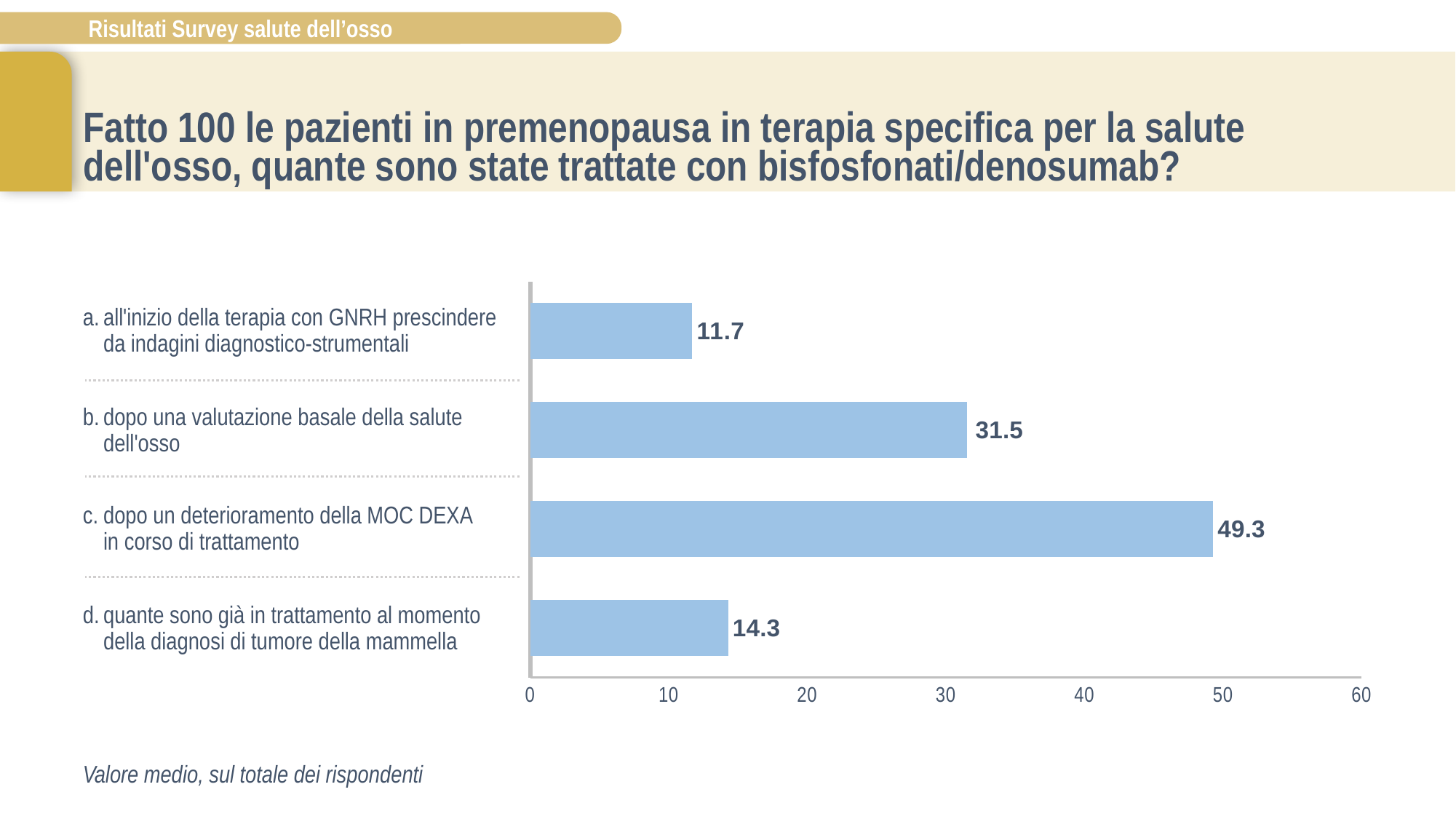
What is the value for option d, 'quante sono già in trattamento al momento della diagnosi di tumore della mammella'? 14.3 Which is larger, the value for option b or the value for option d? option b What is the difference between the values for option c and option b? 17.8 What kind of chart is shown on the slide? bar chart Which option has the lowest value? a. all'inizio della terapia con GNRH prescindere da indagini diagnostico-strumentali What is the difference between the values for option d and option a? 2.6 What is the value for option b, 'dopo una valutazione basale della salute dell'osso'? 31.5 What is the value for option c, 'dopo un deterioramento della MOC DEXA in corso di trattamento'? 49.3 How many categories are shown in the chart? 4 Which option has the highest value? c. dopo un deterioramento della MOC DEXA in corso di trattamento What is the value for option a, 'all'inizio della terapia con GNRH prescindere da indagini diagnostico-strumentali'? 11.7 Is the value for option c greater or less than 40? greater